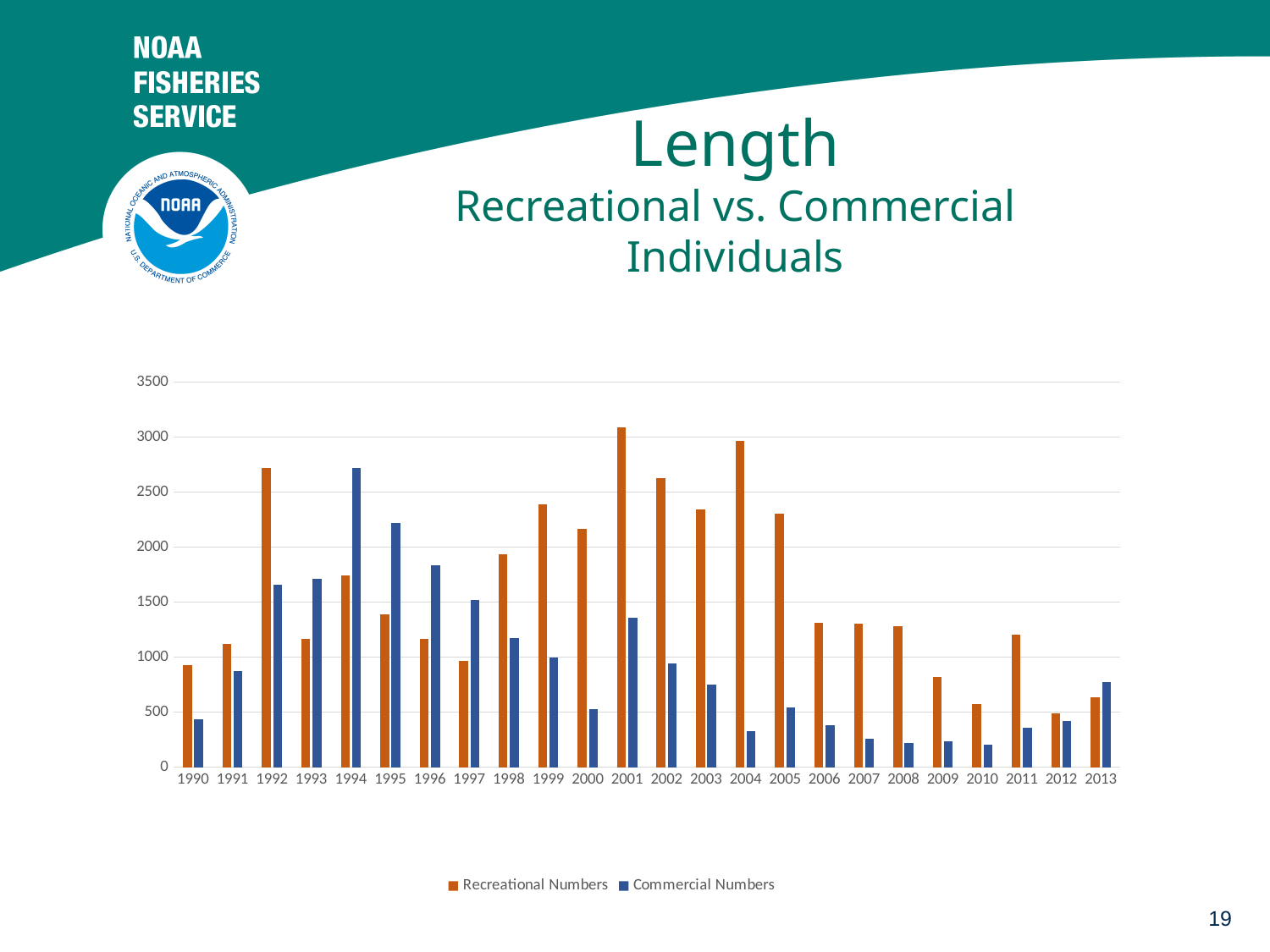
Is the Commercial Numbers value for 1994 greater or less than 2500? greater How many series does the legend list? 2 Is the Recreational Numbers value for 2001 greater or less than 3000? greater In 1994, which is larger: Recreational Numbers or Commercial Numbers? Commercial Numbers Which year has the highest Recreational Numbers value? 2001 How many years are shown along the x axis? 24 What kind of chart is shown on the slide? bar chart In 2001, which is larger: Recreational Numbers or Commercial Numbers? Recreational Numbers Is the Commercial Numbers value for 2010 greater or less than 500? less Which year has the highest Commercial Numbers value? 1994 Which colour represents Commercial Numbers in the legend? blue